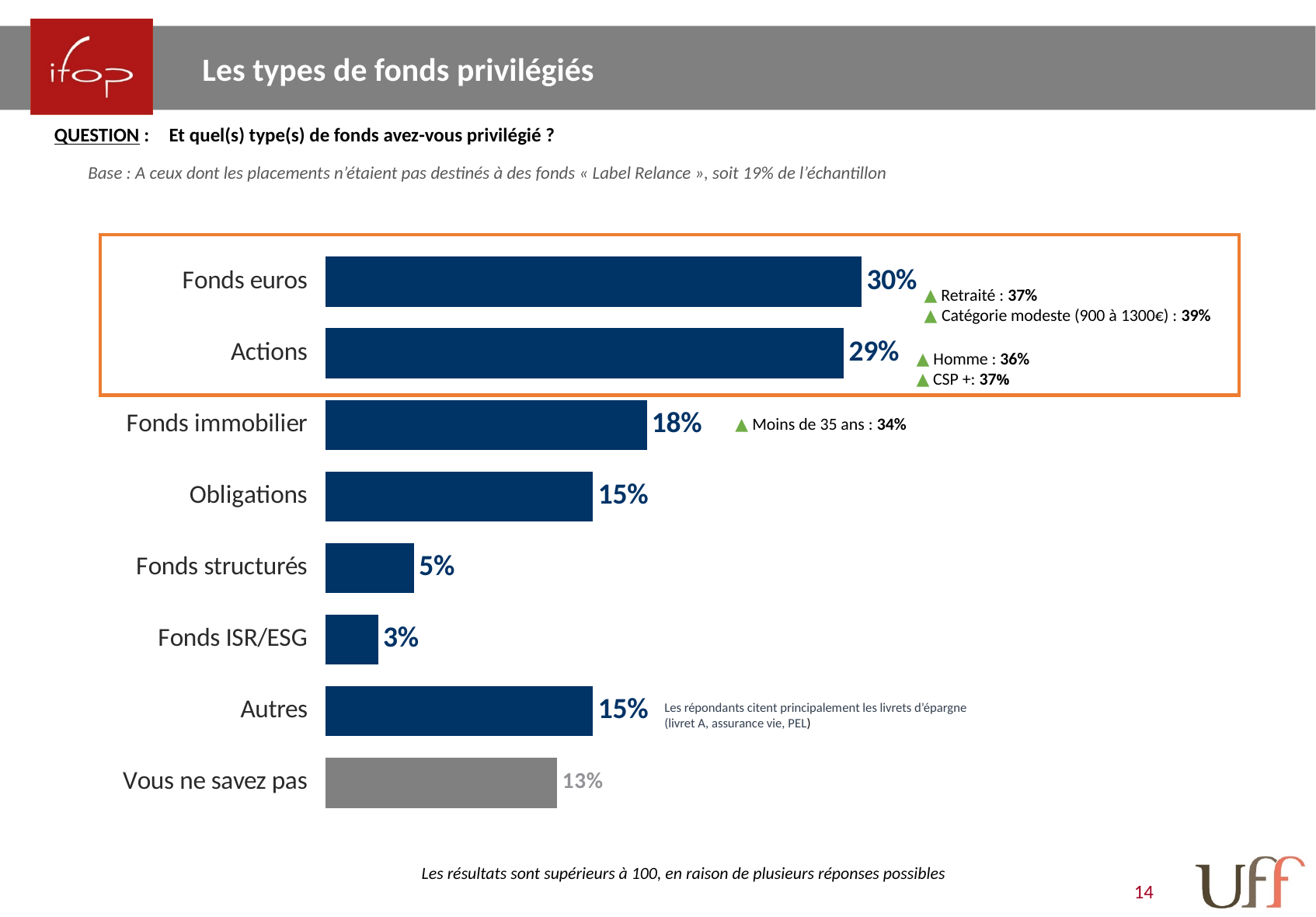
What is the difference between the values for Fonds euros and Fonds immobilier? 12% What is the value for Actions? 29% Which bar is shown in grey rather than dark blue? Vous ne savez pas Which category has the lowest value? Fonds ISR/ESG What is the value for Fonds euros? 30% What kind of chart is shown on the slide? Bar chart Which is larger, the value for Obligations or the value for Fonds structurés? Obligations What is the value for Vous ne savez pas? 13% What is the value for Fonds ISR/ESG? 3% What is the value for Fonds immobilier? 18% How many categories are shown in the chart? 8 Which category has the highest value? Fonds euros